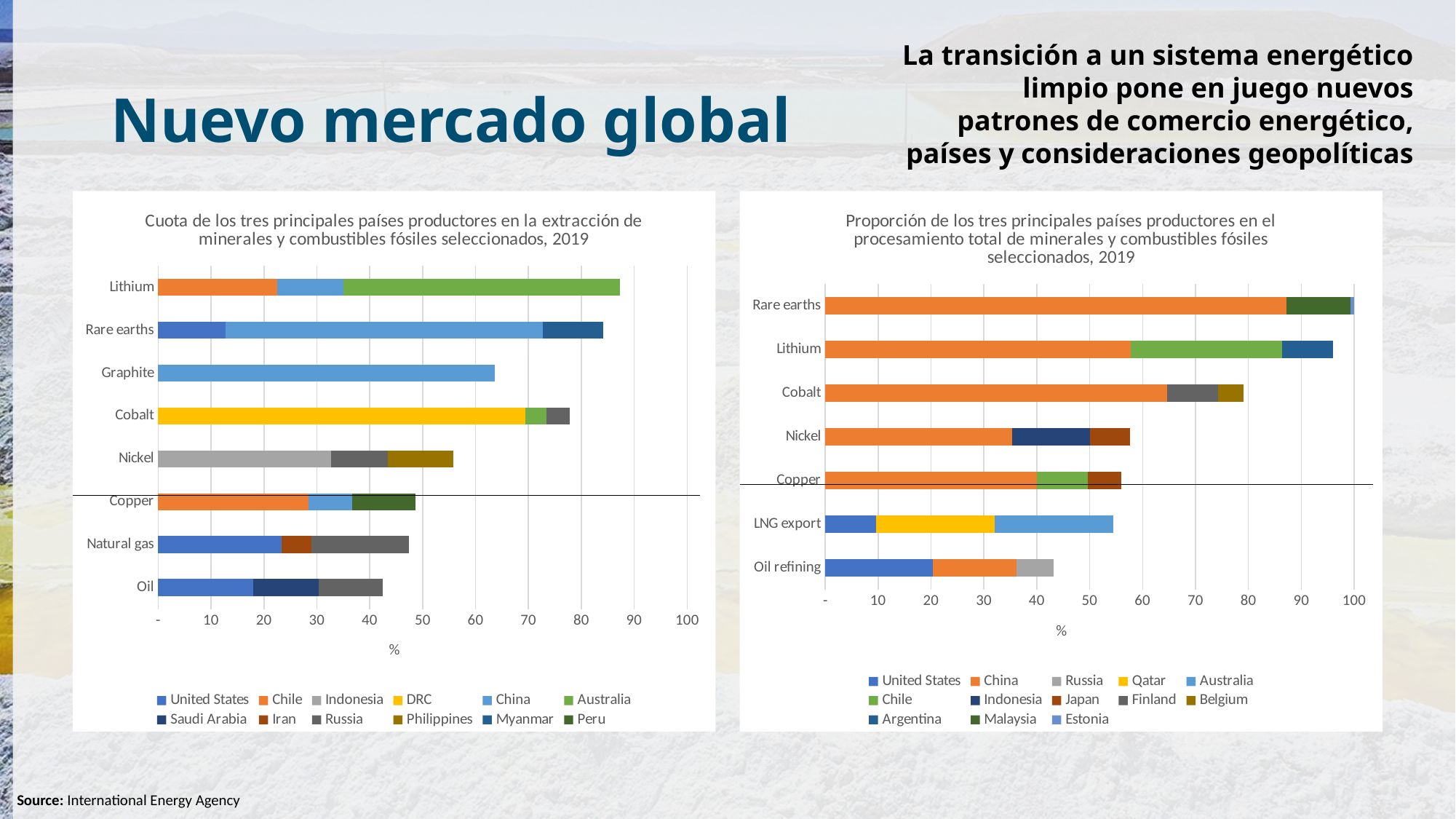
What type of chart is the left chart, 'Cuota de los tres principales países productores en la extracción de minerales y combustibles fósiles seleccionados, 2019'? Stacked bar chart On the right chart about processing shares, which total bar is larger, Lithium or Cobalt? Lithium On the left chart about extraction shares, is the total bar for Graphite greater or less than 60? greater On the left chart about extraction shares, which total bar is larger, Cobalt or Graphite? Cobalt On the left chart about extraction shares, which category has the lowest total bar? Oil How many categories are shown on the right chart about processing shares? 7 How many series does the legend of the right chart list? 13 How many categories are shown on the left chart about extraction shares? 8 On the right chart about processing shares, is the total bar for Oil refining greater or less than 50? less On the right chart about processing shares, which category has the highest total bar? Rare earths How many series does the legend of the left chart list? 12 On the right chart about processing shares, which category has the lowest total bar? Oil refining